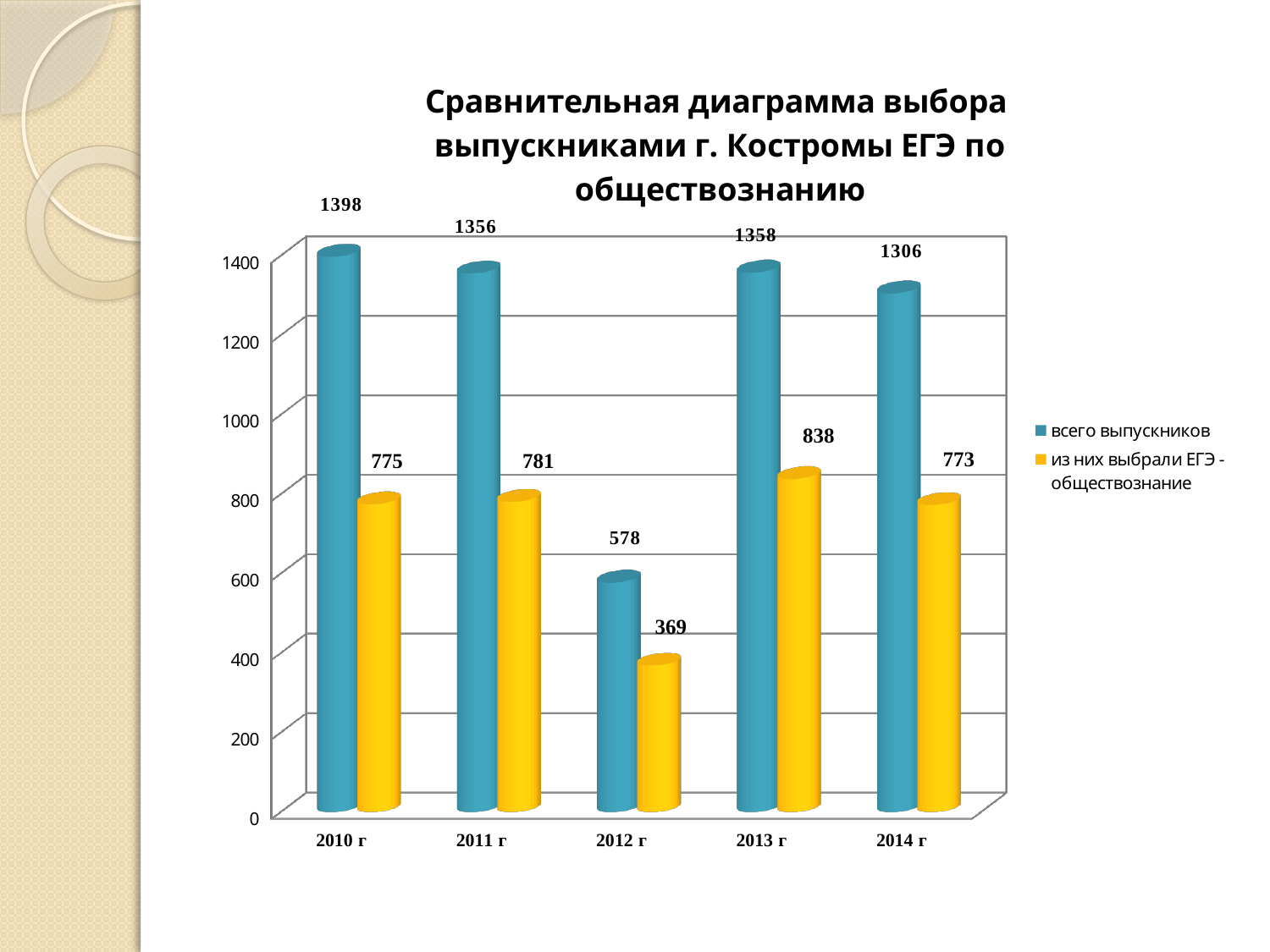
What colour are the bars for "всего выпускников"? blue What is the difference between "всего выпускников" and "из них выбрали ЕГЭ - обществознание" in 2014 г? 533 Is the value for "всего выпускников" in 2012 г greater or less than 600? less Which year has the lowest value for "из них выбрали ЕГЭ - обществознание"? 2012 г Which is larger: "из них выбрали ЕГЭ - обществознание" in 2011 г or in 2013 г? 2013 г What is the value for "из них выбрали ЕГЭ - обществознание" in 2012 г? 369 What is the value for "всего выпускников" in 2010 г? 1398 What is the value for "из них выбрали ЕГЭ - обществознание" in 2013 г? 838 How many series does the legend list? 2 How many years are shown on the x axis? 5 Which year has the highest value for "всего выпускников"? 2010 г What kind of chart is shown on the slide? bar chart